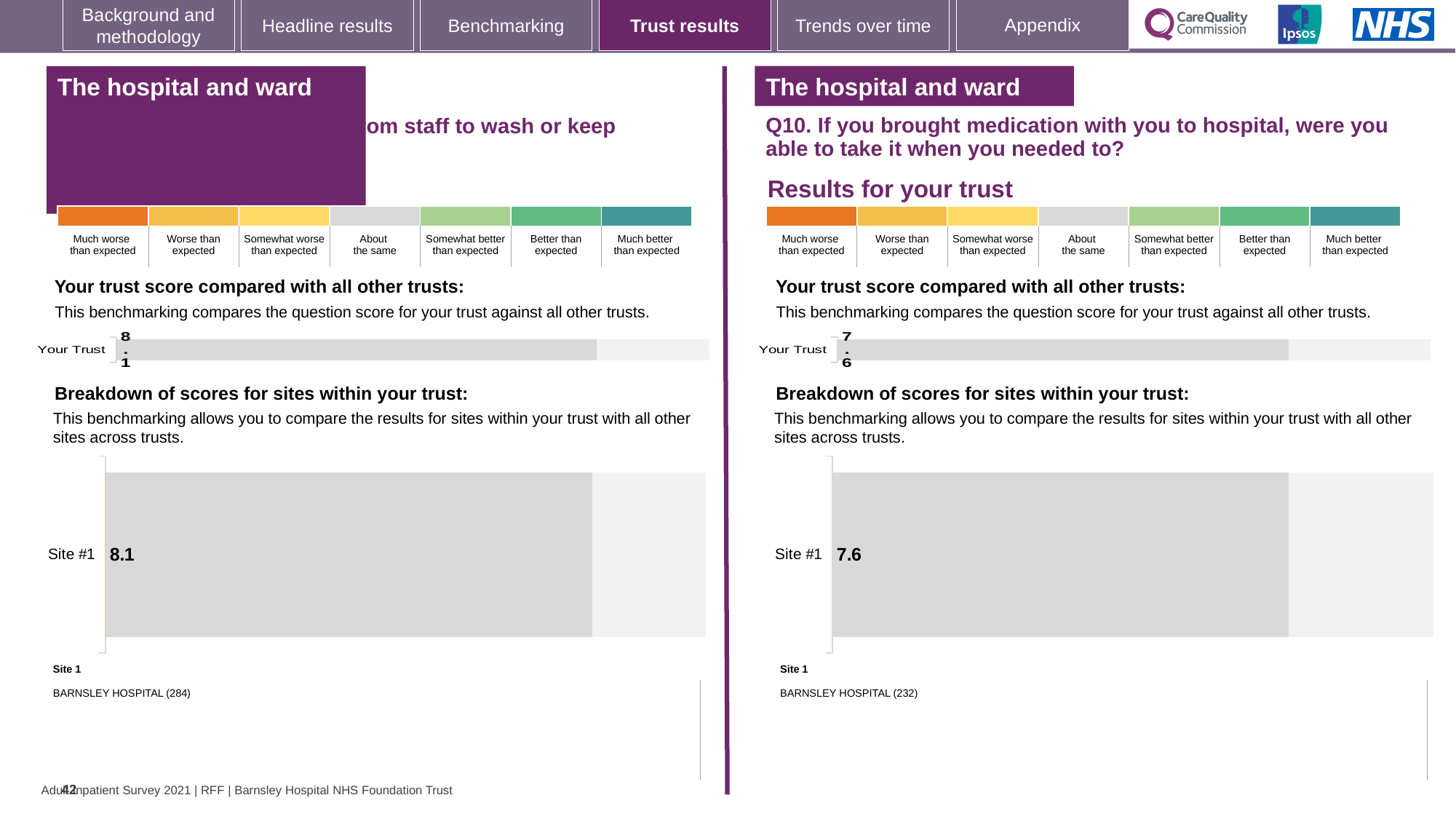
On the right-hand 'Breakdown of scores for sites within your trust' chart (Q10), what is the score for Site #1? 7.6 How many sites are shown on the left-hand 'Breakdown of scores for sites within your trust' chart? 1 How many rating categories are shown in the colour scale above the right-hand Q10 charts, from 'Much worse than expected' to 'Much better than expected'? 7 What is the difference between the Site #1 score on the left-hand breakdown chart (8.1) and the Site #1 score on the right-hand Q10 breakdown chart (7.6)? 0.5 Which Site #1 score is higher: the one on the left-hand breakdown chart or the one on the right-hand (Q10) breakdown chart? The left-hand chart (8.1) Which 'Your Trust' score is higher: the one on the left-hand chart or the one on the right-hand Q10 chart? The left-hand chart (8.1) What kind of chart is used to show the Site #1 score on the right-hand Q10 breakdown chart? Bar chart On the right-hand Q10 section, which hospital is listed as Site 1 below the breakdown chart? BARNSLEY HOSPITAL (232) On the left-hand 'Your trust score compared with all other trusts' chart, what is the score shown for 'Your Trust'? 8.1 On the right-hand chart for Q10 (medication), what is the score shown for 'Your Trust'? 7.6 On the left-hand 'Breakdown of scores for sites within your trust' chart, what is the score for Site #1? 8.1 How many sites are shown on the right-hand Q10 'Breakdown of scores for sites within your trust' chart? 1